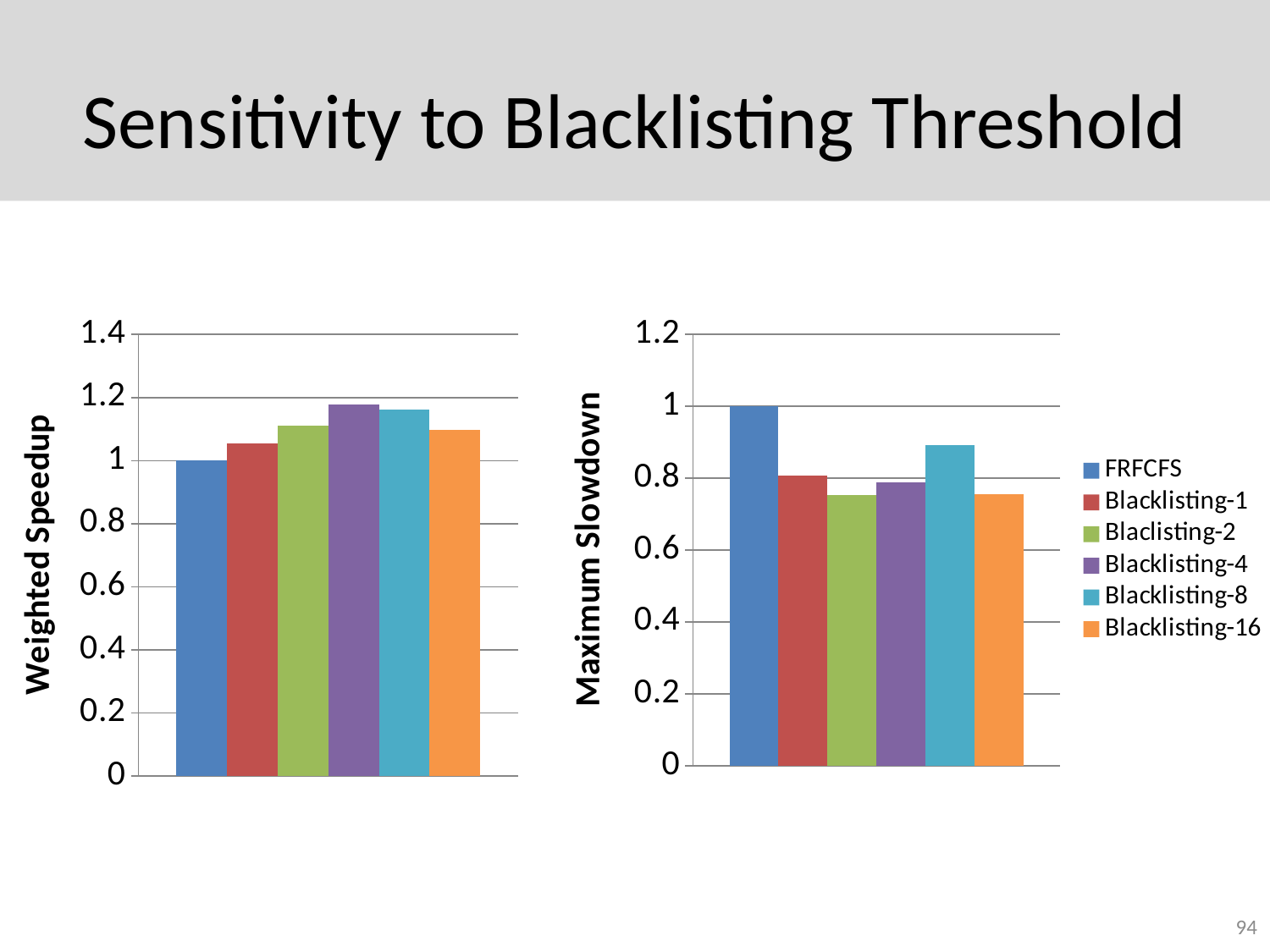
What kind of chart is the Weighted Speedup chart on the left? bar chart How many series does the legend list? 6 In the Weighted Speedup chart on the left, which series has the lowest value? FRFCFS In the Maximum Slowdown chart on the right, which is larger, the value for FRFCFS or the value for Blacklisting-8? FRFCFS In the Maximum Slowdown chart on the right, which series has the highest value? FRFCFS In the Maximum Slowdown chart on the right, is the value for Blacklisting-8 greater or less than 1? less In the Weighted Speedup chart on the left, is the value for Blacklisting-16 greater or less than 1.2? less What is the y-axis title of the chart on the right? Maximum Slowdown In the Weighted Speedup chart on the left, is the value for Blacklisting-4 greater or less than 1? greater In the Weighted Speedup chart on the left, which series has the highest value? Blacklisting-4 In the Weighted Speedup chart on the left, what is the value for FRFCFS? 1 In the Maximum Slowdown chart on the right, what is the value for FRFCFS? 1